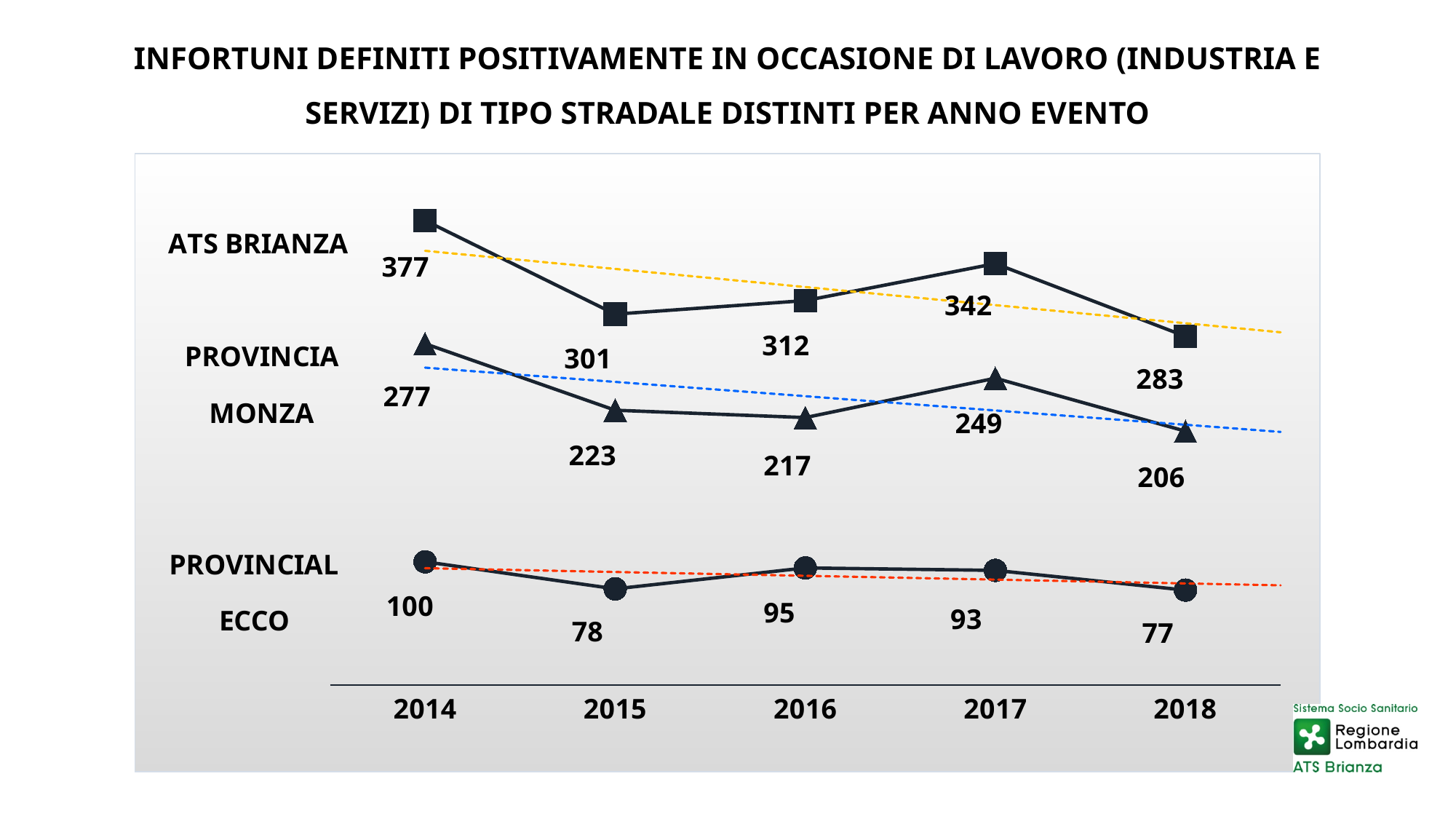
In which year is the PROVINCIA MONZA value lowest? 2018 What is the value for ATS BRIANZA in 2014? 377 How many data series are plotted on the chart? 3 In which year is the ATS BRIANZA value highest? 2014 What is the difference between the ATS BRIANZA values in 2014 and 2018? 94 What is the value for the bottom series (PROVINCIA LECCO) in 2015? 78 Does the ATS BRIANZA series overall rise or fall from 2014 to 2018? Fall What kind of chart is shown on the slide? Line chart What is the difference between the PROVINCIA MONZA values in 2015 and 2016? 6 What is the value for PROVINCIA MONZA in 2017? 249 How many years are shown on the x axis? 5 Which is larger: the ATS BRIANZA value in 2016 or in 2017? 2017